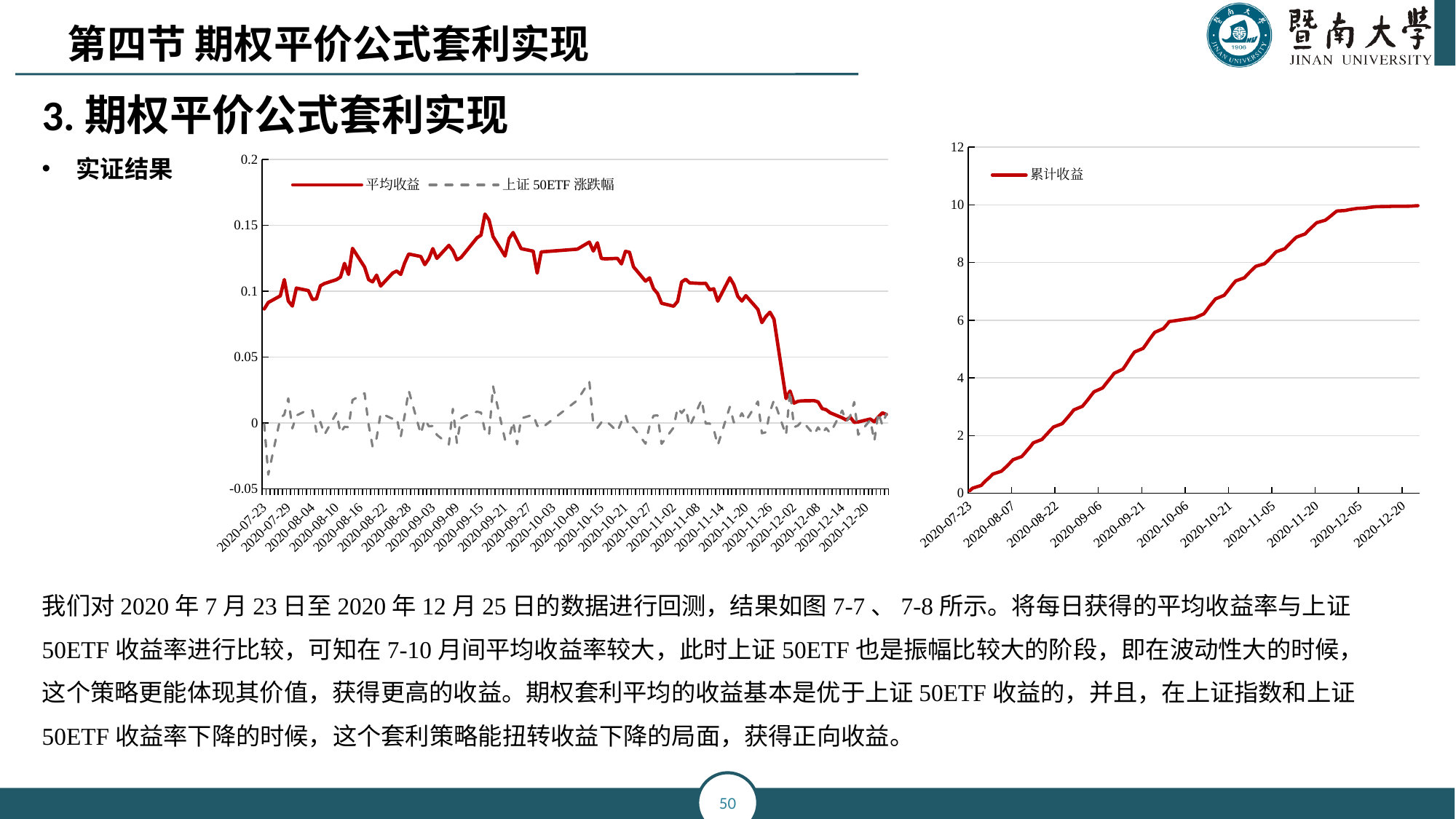
In the right chart, is the value of 累计收益 at 2020-12-20 greater or less than 8? greater What is the name of the series plotted in the right chart? 累计收益 In the left chart, which series is drawn as a grey dashed line? 上证 50ETF 涨跌幅 In the right chart, does 累计收益 generally rise or fall from 2020-07-23 to 2020-12-20? rise In the left chart, at 2020-09-15, which series has the larger value, 平均收益 or 上证 50ETF 涨跌幅? 平均收益 In the right chart, is the value of 累计收益 at 2020-08-22 greater or less than 4? less In the left chart, is the value of 平均收益 at 2020-09-15 greater or less than 0.1? greater What kind of chart is the right chart (累计收益) on the slide? line chart What kind of chart is the left chart on the slide? line chart How many series does the legend of the left chart list? 2 How many series does the legend of the right chart list? 1